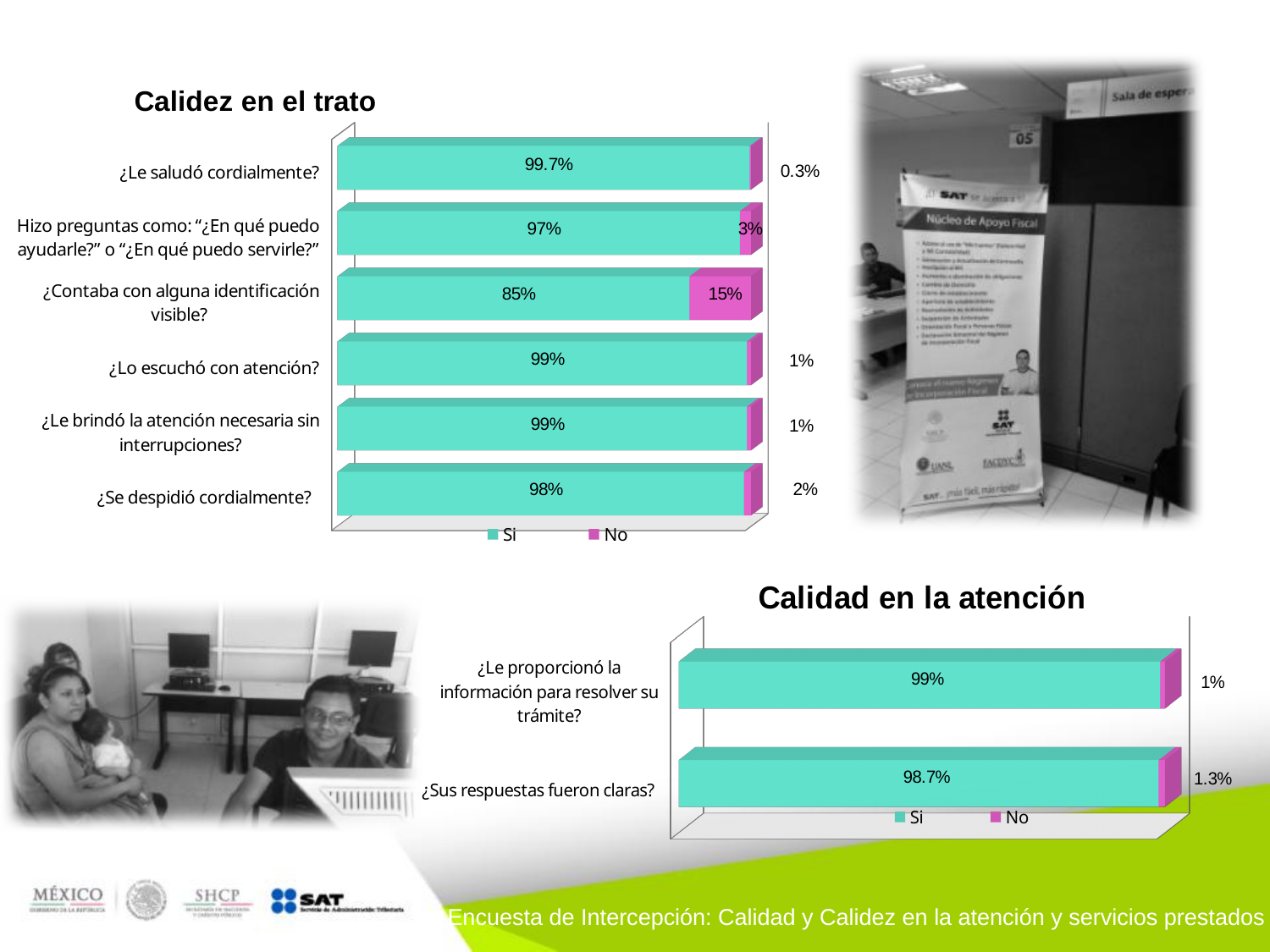
In the 'Calidez en el trato' chart, how many series does the legend list? 2 In the 'Calidez en el trato' chart, what is the 'No' value for '¿Contaba con alguna identificación visible?'? 15% In the 'Calidez en el trato' chart, how many questions (categories) are shown? 6 In the 'Calidez en el trato' chart, what is the 'No' value for 'Hizo preguntas como: ¿En qué puedo ayudarle? o ¿En qué puedo servirle?'? 3% In the 'Calidez en el trato' chart, which question has the lowest 'Si' value? ¿Contaba con alguna identificación visible? In the 'Calidez en el trato' chart, which question has the highest 'Si' value? ¿Le saludó cordialmente? In the 'Calidez en el trato' chart, what is the 'Si' value for '¿Le saludó cordialmente?'? 99.7% In the 'Calidad en la atención' chart, what is the 'Si' value for '¿Sus respuestas fueron claras?'? 98.7% In the 'Calidez en el trato' chart, what is the difference between the 'Si' values for '¿Le saludó cordialmente?' and '¿Se despidió cordialmente?'? 1.7% In the 'Calidad en la atención' chart, which question has the larger 'No' value: '¿Le proporcionó la información para resolver su trámite?' or '¿Sus respuestas fueron claras?'? ¿Sus respuestas fueron claras? What kind of chart is 'Calidad en la atención'? Bar chart In the 'Calidad en la atención' chart, what colour represents the 'No' series? Magenta/pink